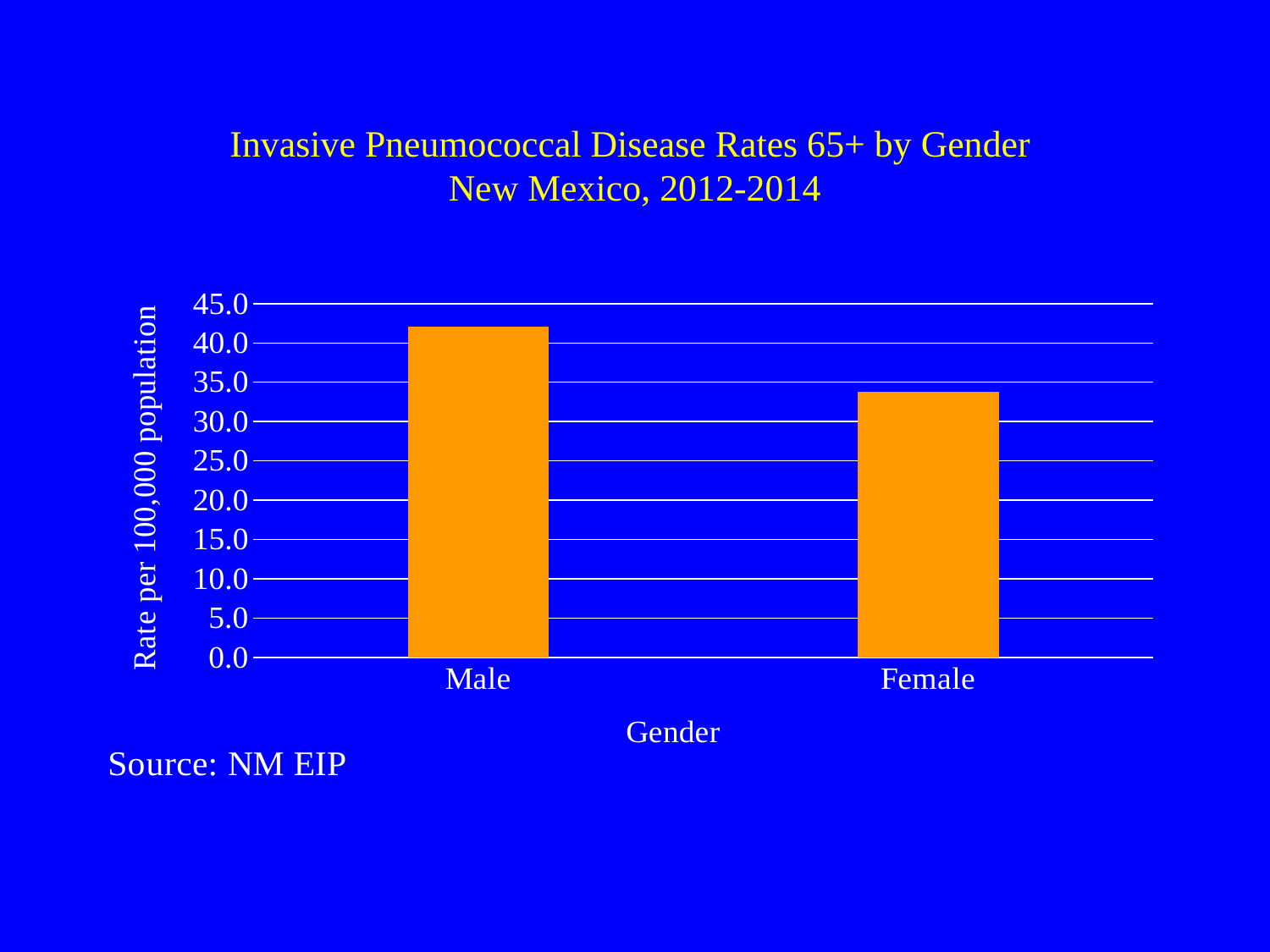
How many categories are shown on the x axis? 2 Is the value for Male larger or smaller than the value for Female? larger Is the rate for Male greater or less than 40.0? greater What is the label of the y axis? Rate per 100,000 population What type of chart is shown on the slide? bar chart What is the title of the chart? Invasive Pneumococcal Disease Rates 65+ by Gender New Mexico, 2012-2014 Is the rate for Female greater or less than 30.0? greater Which gender has the lower invasive pneumococcal disease rate? Female Is the rate for Female greater or less than 35.0? less Which gender has the higher invasive pneumococcal disease rate? Male